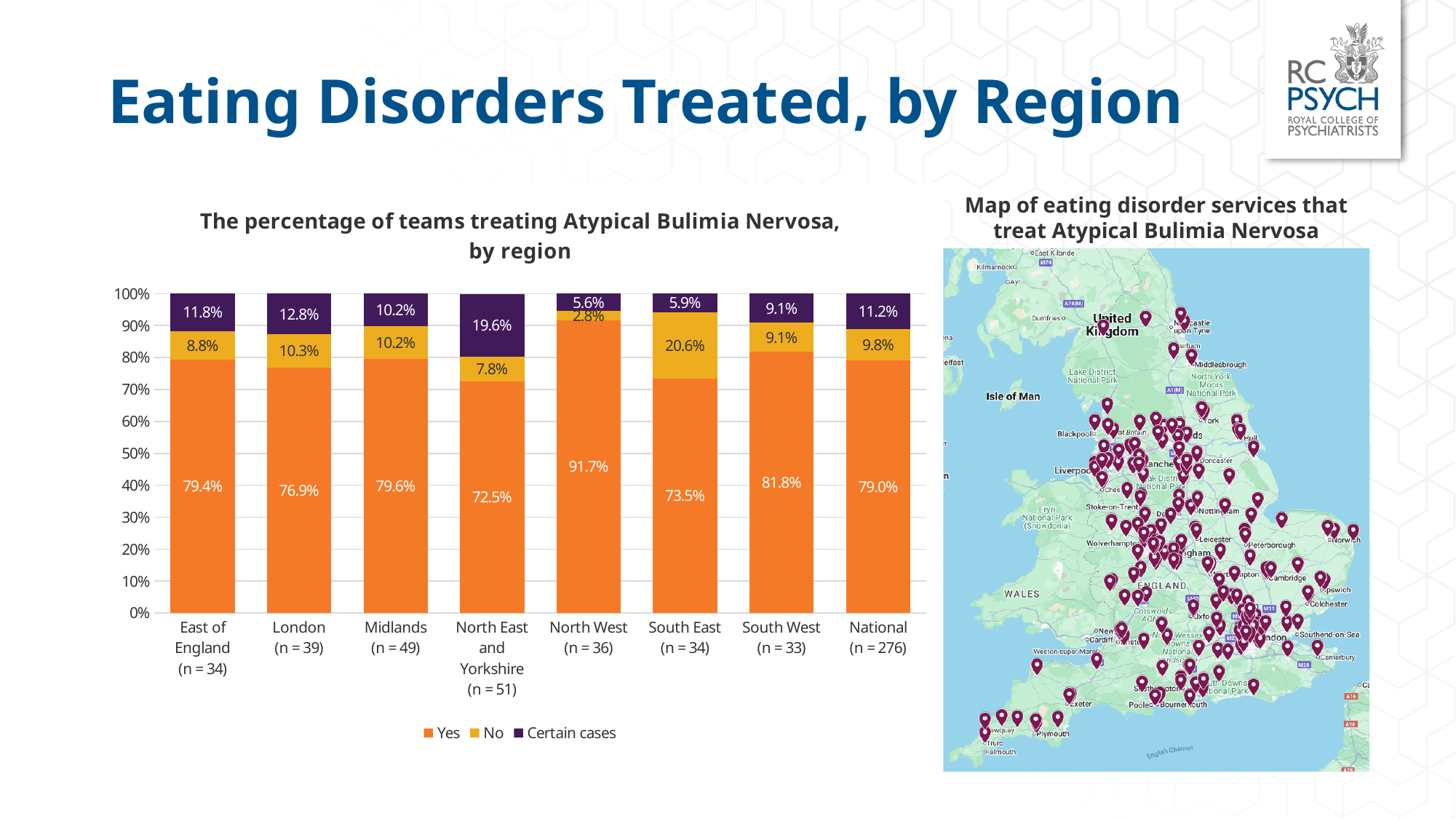
Which region has the lowest 'Yes' percentage? North East and Yorkshire What percentage of teams in the North West answered 'Yes' to treating Atypical Bulimia Nervosa? 91.7% What is the National 'Yes' percentage? 79.0% Which is larger, the 'Certain cases' percentage for London or for the Midlands? London How many regions (including National) are shown on the x axis of the chart? 8 What type of chart is used to show the percentage of teams treating Atypical Bulimia Nervosa by region? Stacked bar chart Which region has the highest 'No' percentage? South East What is the 'No' percentage for the South East? 20.6% What is the difference between the 'Yes' percentages for the North West and London? 14.8% Which region has the highest 'Yes' percentage? North West What is the 'Certain cases' percentage for North East and Yorkshire? 19.6% How many series does the chart legend list? 3